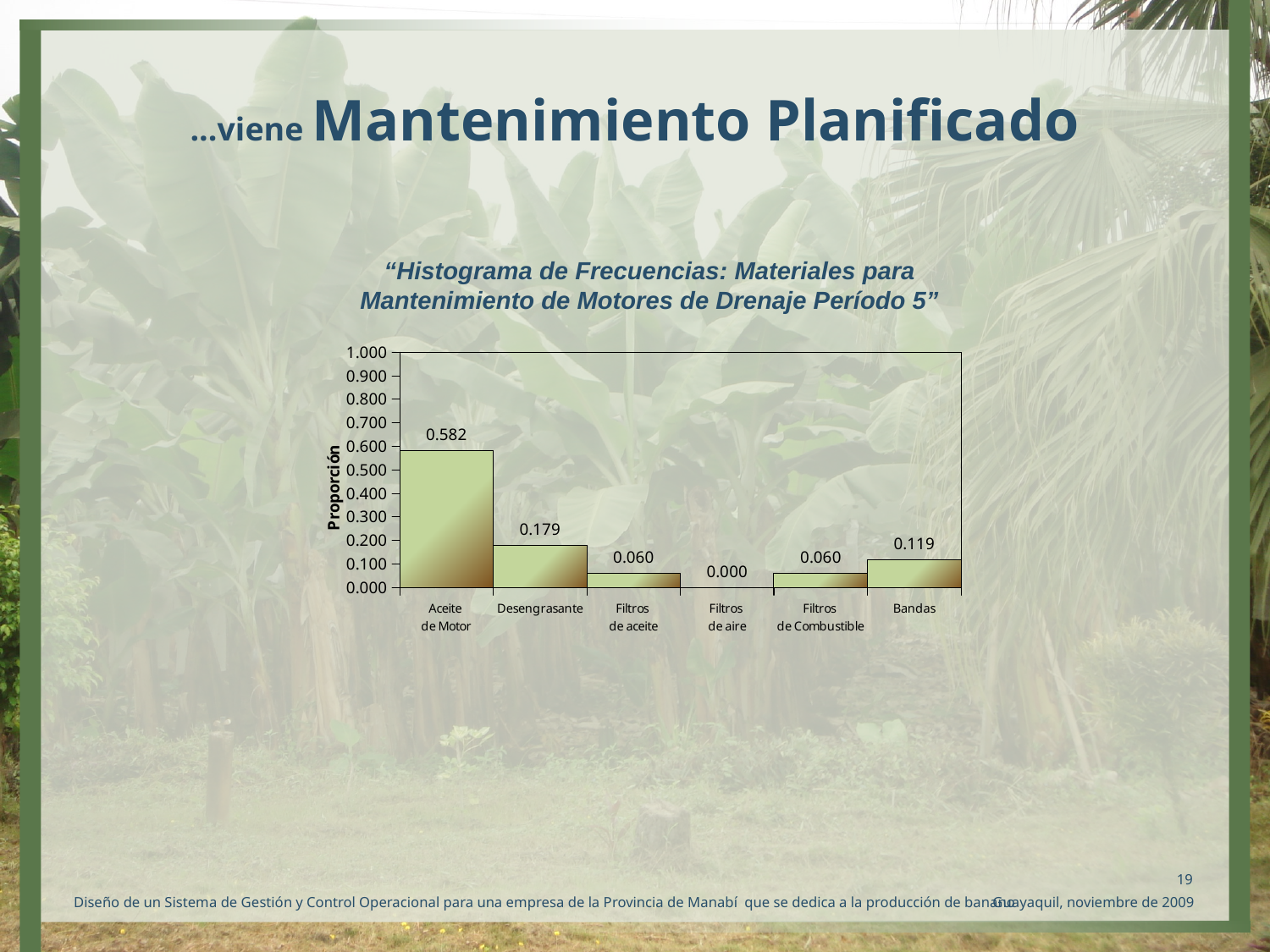
Which category has the lowest proportion? Filtros de aire What kind of chart is shown on the slide? bar chart Which category has the highest proportion? Aceite de Motor What is the proportion for Aceite de Motor? 0.582 What is the label of the y axis? Proporción What is the proportion for Bandas? 0.119 What is the difference between the proportions for Aceite de Motor and Desengrasante? 0.403 How many categories are shown on the x axis? 6 Is the value for Aceite de Motor greater or less than 0.500? greater Which is larger, the proportion for Bandas or for Filtros de Combustible? Bandas What is the proportion for Filtros de aire? 0.000 What is the proportion for Desengrasante? 0.179